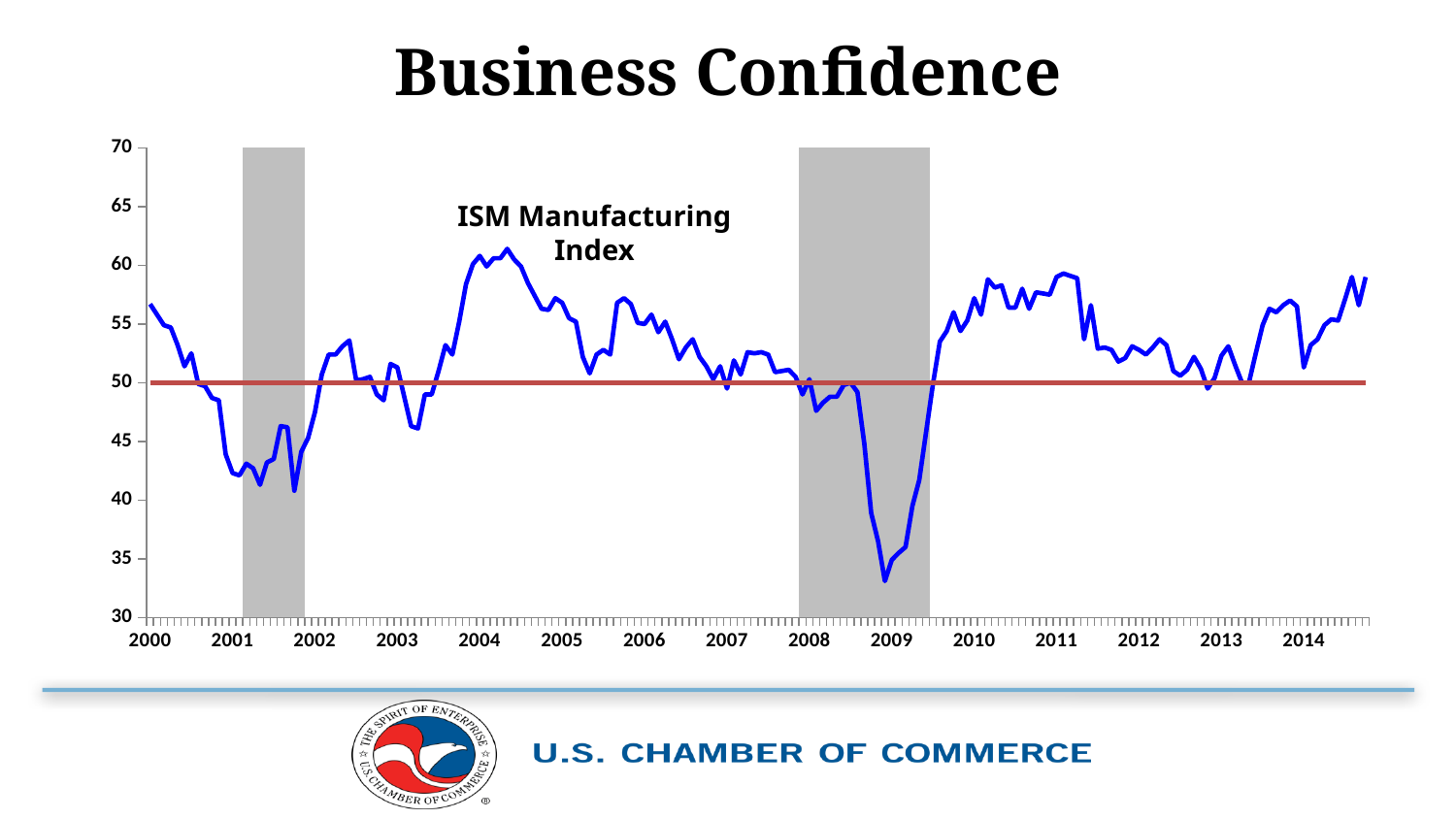
What is the title of the slide's chart? Business Confidence Does the ISM Manufacturing Index rise or fall between the start of 2008 and the start of 2009? fall What kind of chart is shown on the slide? line chart At what value is the horizontal red reference line drawn? 50 How many data series are plotted as lines in the chart (excluding the reference line)? 1 Is the value of the ISM Manufacturing Index at the start of 2000 greater or less than 55? greater Is the value of the ISM Manufacturing Index at the end of 2014 greater or less than 55? greater Is the peak value of the ISM Manufacturing Index in 2004 greater or less than 55? greater Does the ISM Manufacturing Index rise or fall between the start of 2009 and the start of 2010? rise In which of the two shaded periods does the ISM Manufacturing Index reach its lowest value? the second (2008–2009)